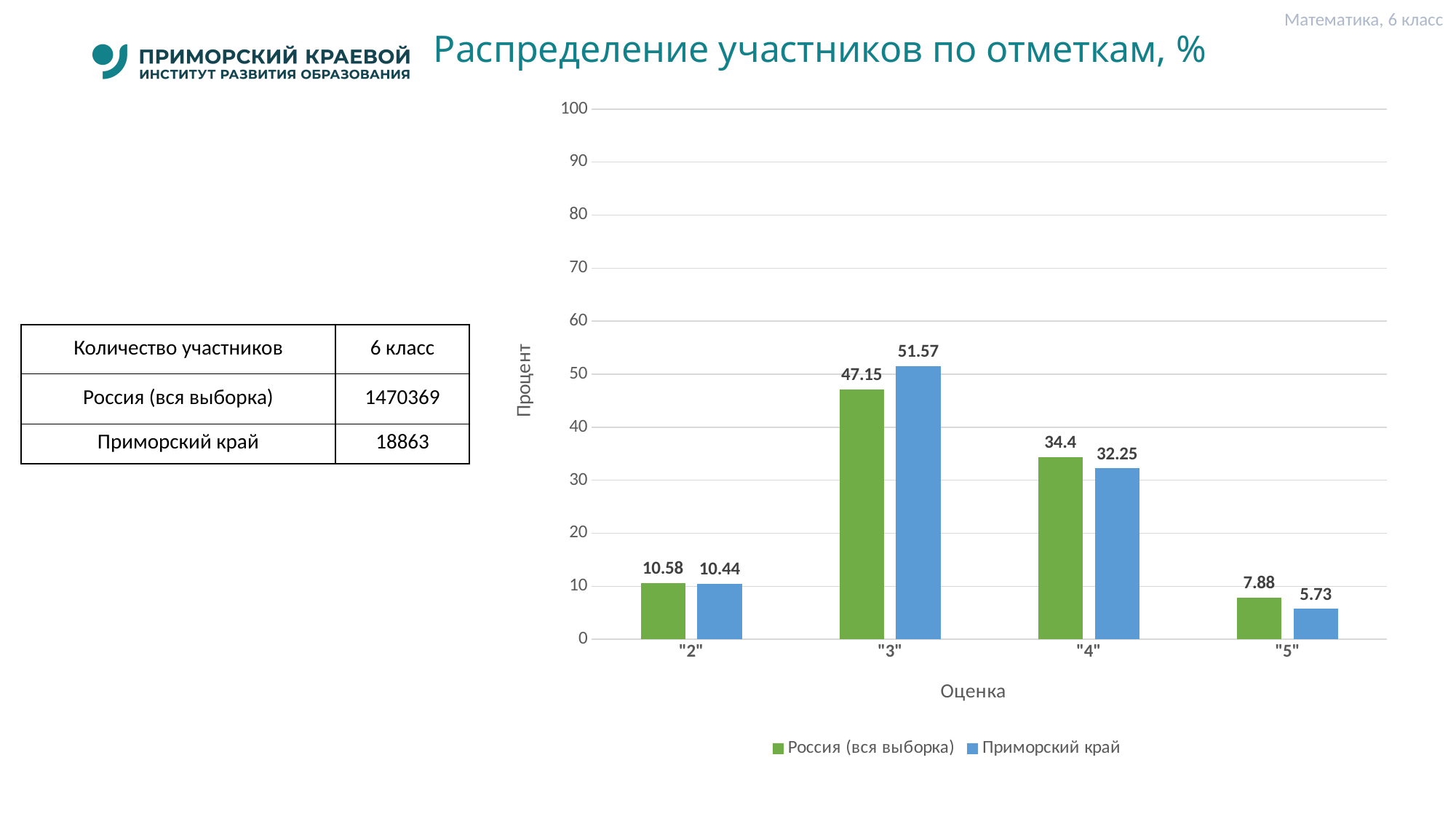
What is the difference between Приморский край and Россия (вся выборка) at grade "3"? 4.42 How many grade categories are shown on the x axis? 4 What is the difference between Россия (вся выборка) and Приморский край at grade "4"? 2.15 Which grade has the lowest value for Россия (вся выборка)? "5" Which grade has the highest value for Приморский край? "3" Is the value for Приморский край at grade "3" greater or less than 50? greater What is the value for Приморский край at grade "2"? 10.44 What kind of chart is shown on the slide? bar chart What is the value for Приморский край at grade "5"? 5.73 How many series does the legend list? 2 What is the value for Россия (вся выборка) at grade "3"? 47.15 Which series has the larger value at grade "4"? Россия (вся выборка)